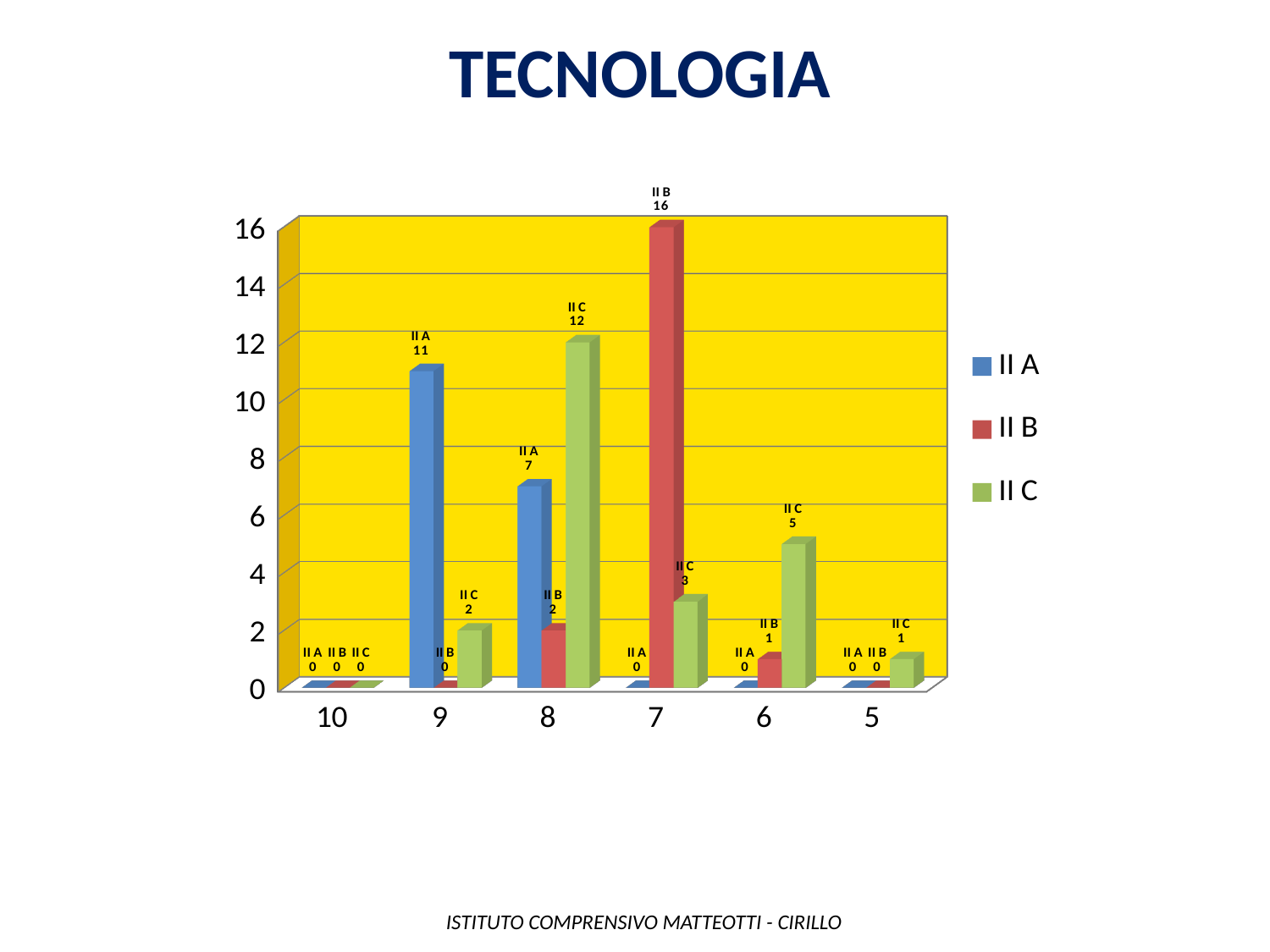
Which grade has the highest value for II B? 7 How many grade categories are shown on the x axis? 6 Which is larger at grade 9: II A or II C? II A Which grade has the highest value for II C? 8 What kind of chart is shown? bar chart What is the value for II B at grade 7? 16 What is the value for II C at grade 6? 5 What is the difference between II C and II A at grade 8? 5 What is the value for II C at grade 8? 12 How many series does the legend list? 3 What is the value for II A at grade 9? 11 What is the total of II A, II B and II C at grade 7? 19